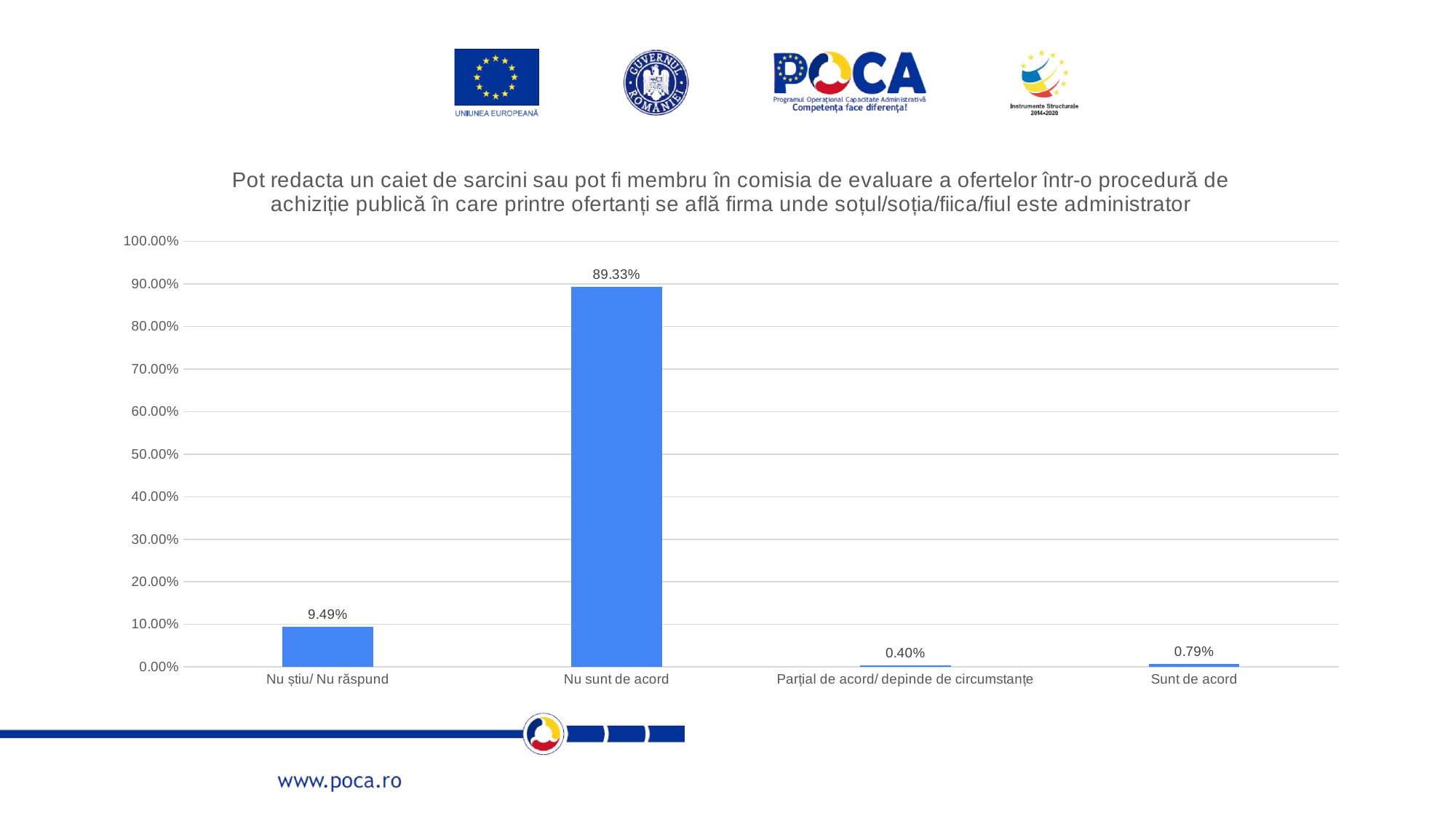
Which category has the highest value? Nu sunt de acord What is the difference between the values for "Sunt de acord" and "Parțial de acord/ depinde de circumstanțe"? 0.39% Which category has the lowest value? Parțial de acord/ depinde de circumstanțe What is the value for "Sunt de acord"? 0.79% What is the value for "Nu știu/ Nu răspund"? 9.49% Is the value for "Nu sunt de acord" greater or less than 80.00%? greater What kind of chart is shown on the slide? bar chart Which is larger, the value for "Sunt de acord" or the value for "Parțial de acord/ depinde de circumstanțe"? Sunt de acord What is the value for "Parțial de acord/ depinde de circumstanțe"? 0.40% What is the value for "Nu sunt de acord"? 89.33% How many categories are shown on the x axis? 4 What is the difference between the values for "Nu sunt de acord" and "Nu știu/ Nu răspund"? 79.84%